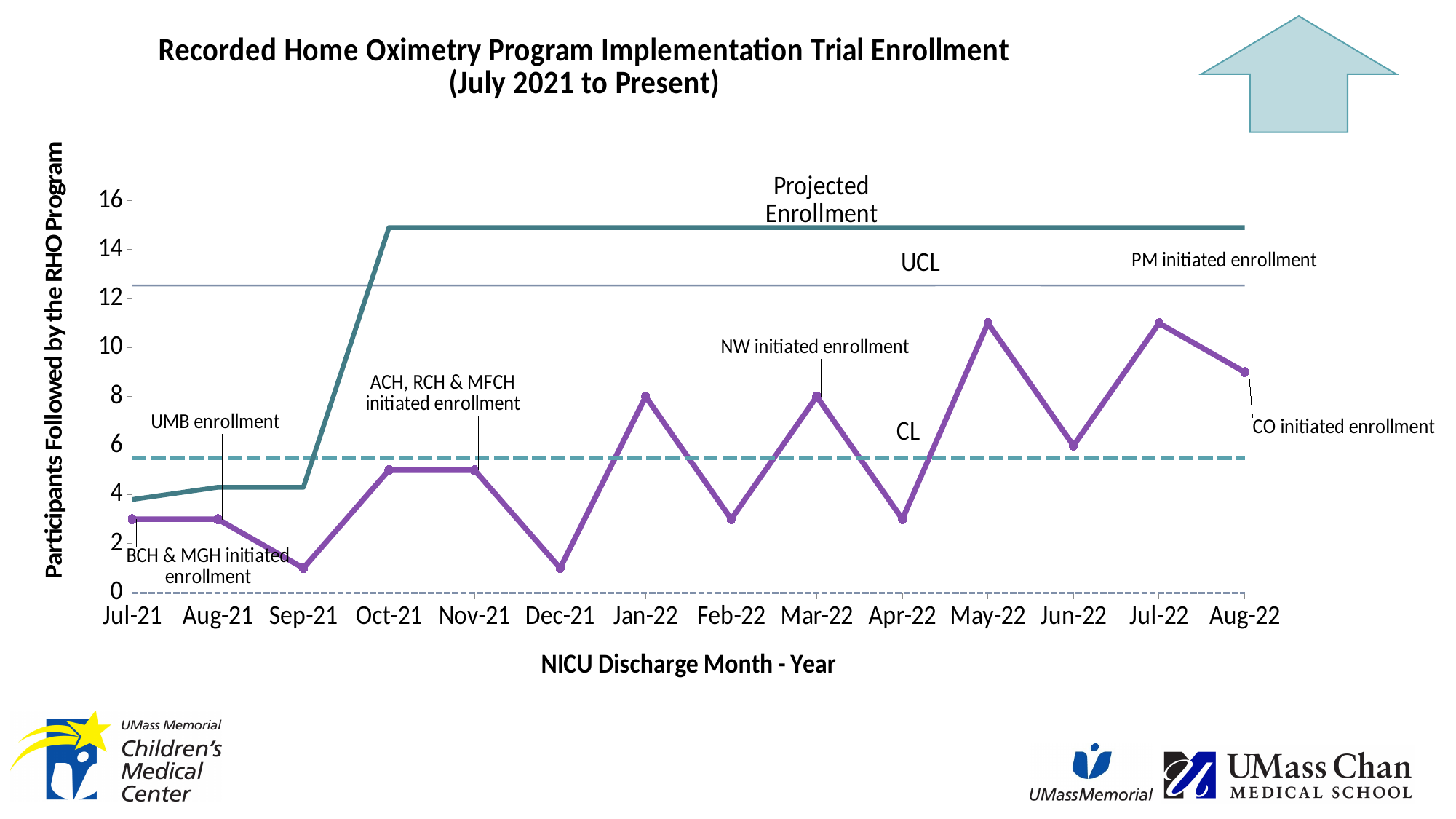
What is the number of participants followed by the RHO Program for Jan-22? 8 What is the number of participants followed by the RHO Program for Mar-22? 8 What kind of chart is shown on the slide? line chart What is the number of participants followed by the RHO Program for Jun-22? 6 Is the value for Sep-21 greater or less than 2? less How many months are plotted along the x axis? 14 What is the difference between the participants for Jan-22 and Jun-22? 2 Which month has the larger value, Jan-22 or Feb-22? Jan-22 Does the participant line rise or fall from Jul-22 to Aug-22? fall Is the value for May-22 greater or less than 10? greater What is the title of the x axis? NICU Discharge Month - Year Is the value for Aug-22 greater or less than 8? greater